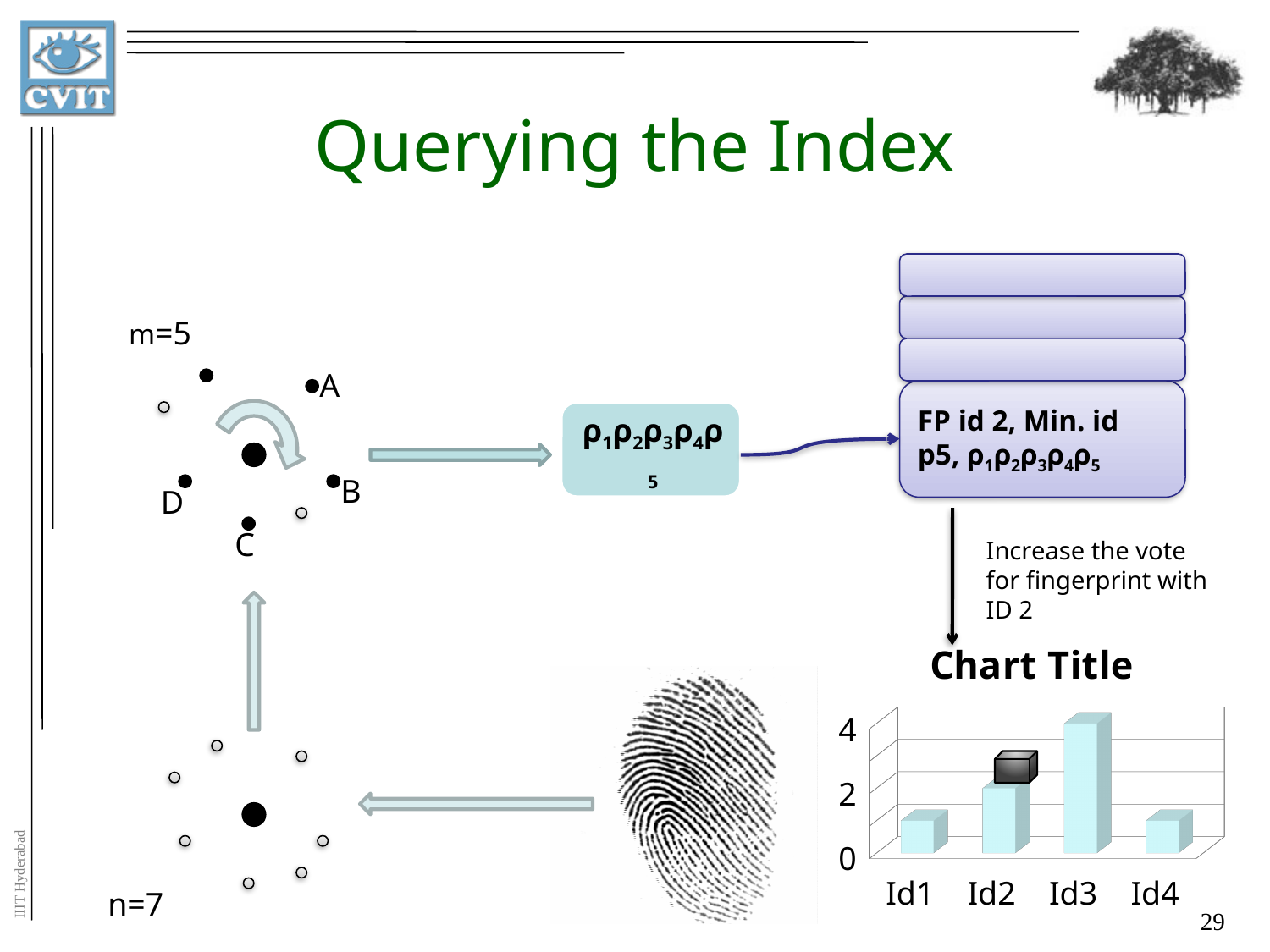
What kind of chart is shown on the slide? bar chart Which category has the highest bar in the chart? Id3 Which is larger, the bar for Id3 or the bar for Id4? Id3 What is the highest tick value shown on the vertical axis of the chart? 4 Which is larger, the bar for Id1 or the bar for Id2? Id2 How many categories are shown on the x axis of the chart? 4 Which is larger, the bar for Id2 or the bar for Id3? Id3 Is the value for Id3 greater or less than 2? greater What is the title of the chart on the slide? Chart Title Is the value for Id4 greater or less than 2? less Is the value for Id1 greater or less than 2? less